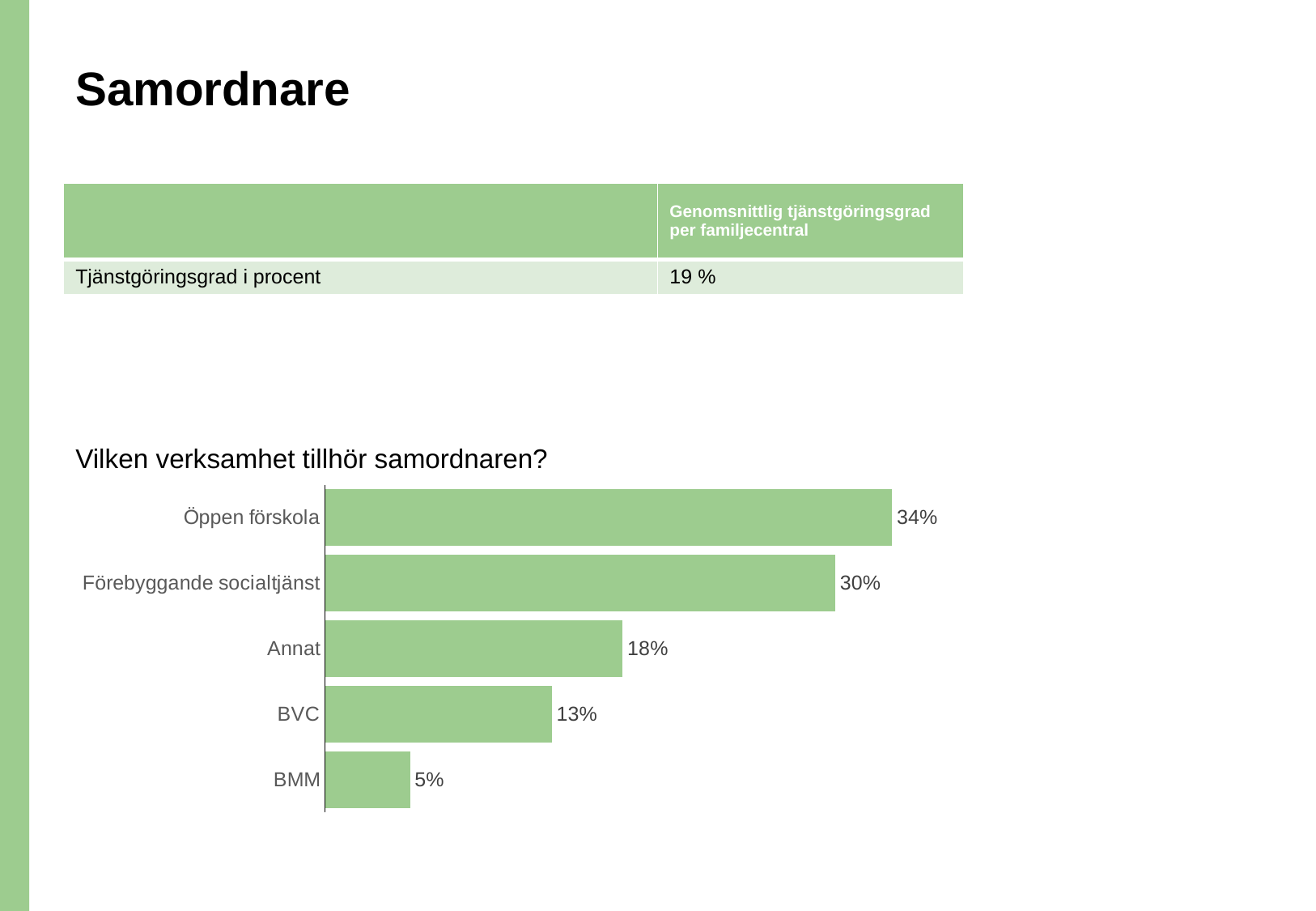
What is the title of the chart? Vilken verksamhet tillhör samordnaren? What is the value for BMM? 5% Which category has the lowest value? BMM What is the difference between the values for Öppen förskola and Förebyggande socialtjänst? 4% How many categories are shown in the chart? 5 What is the value for Förebyggande socialtjänst? 30% What is the value for Öppen förskola? 34% Which category has the highest value? Öppen förskola What is the value for BVC? 13% What kind of chart is shown on the slide? Bar chart Which is larger, the value for Annat or the value for BVC? Annat What is the difference between the values for Annat and BVC? 5%